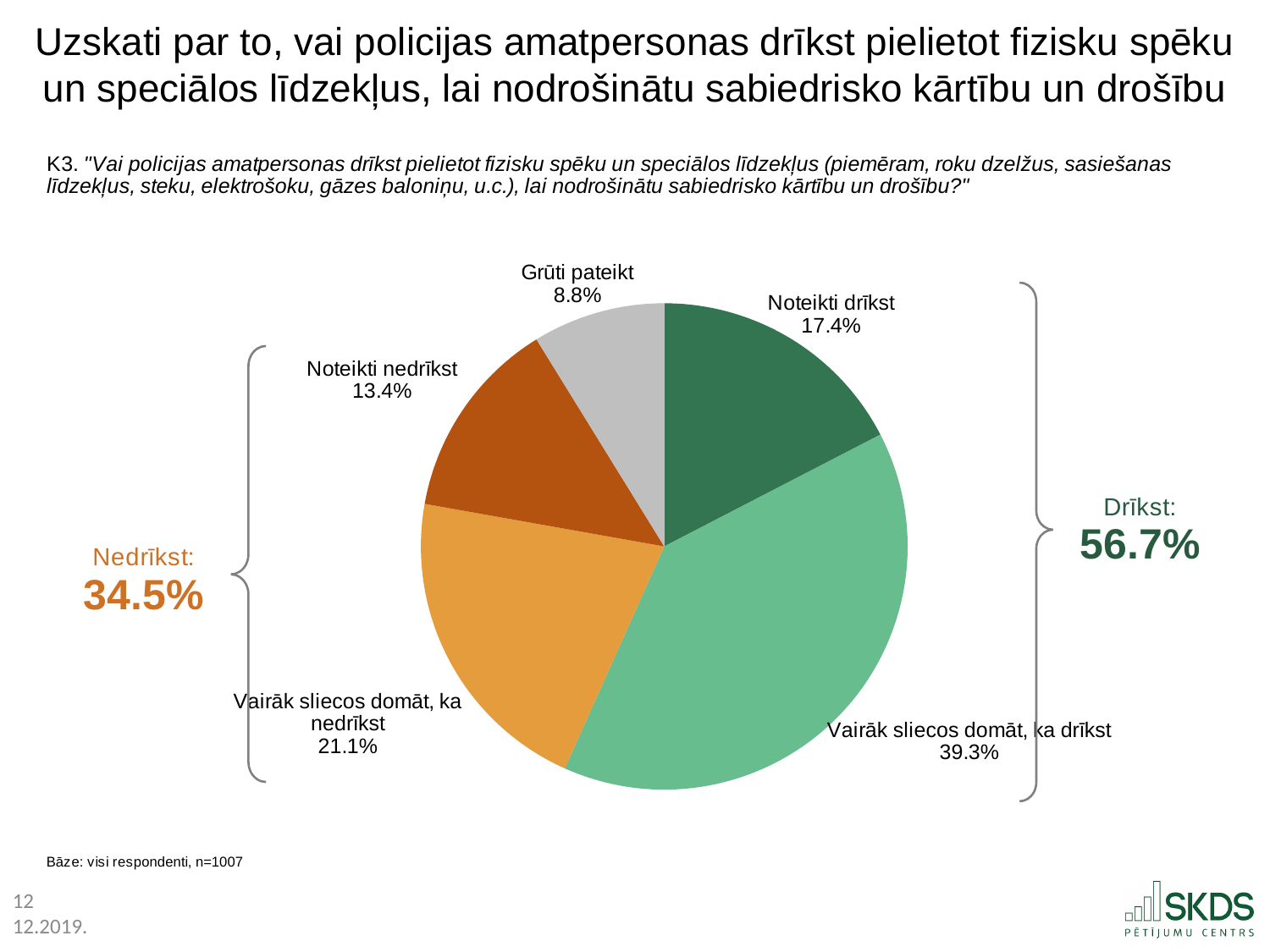
Which answer category has the smallest slice of the pie? Grūti pateikt What share of respondents answered "Grūti pateikt"? 8.8% What share of respondents answered "Noteikti nedrīkst"? 13.4% What is the difference between the shares for "Vairāk sliecos domāt, ka drīkst" and "Vairāk sliecos domāt, ka nedrīkst"? 18.2% What share of respondents answered "Vairāk sliecos domāt, ka drīkst"? 39.3% Which answer category has the largest slice of the pie? Vairāk sliecos domāt, ka drīkst What kind of chart is shown on the slide? pie chart What share of respondents answered "Noteikti drīkst"? 17.4% What combined share is shown for "Drīkst" on the slide? 56.7% How many slices does the pie chart have? 5 Which is larger: the share for "Noteikti drīkst" or the share for "Noteikti nedrīkst"? Noteikti drīkst What combined share is shown for "Nedrīkst" on the slide? 34.5%